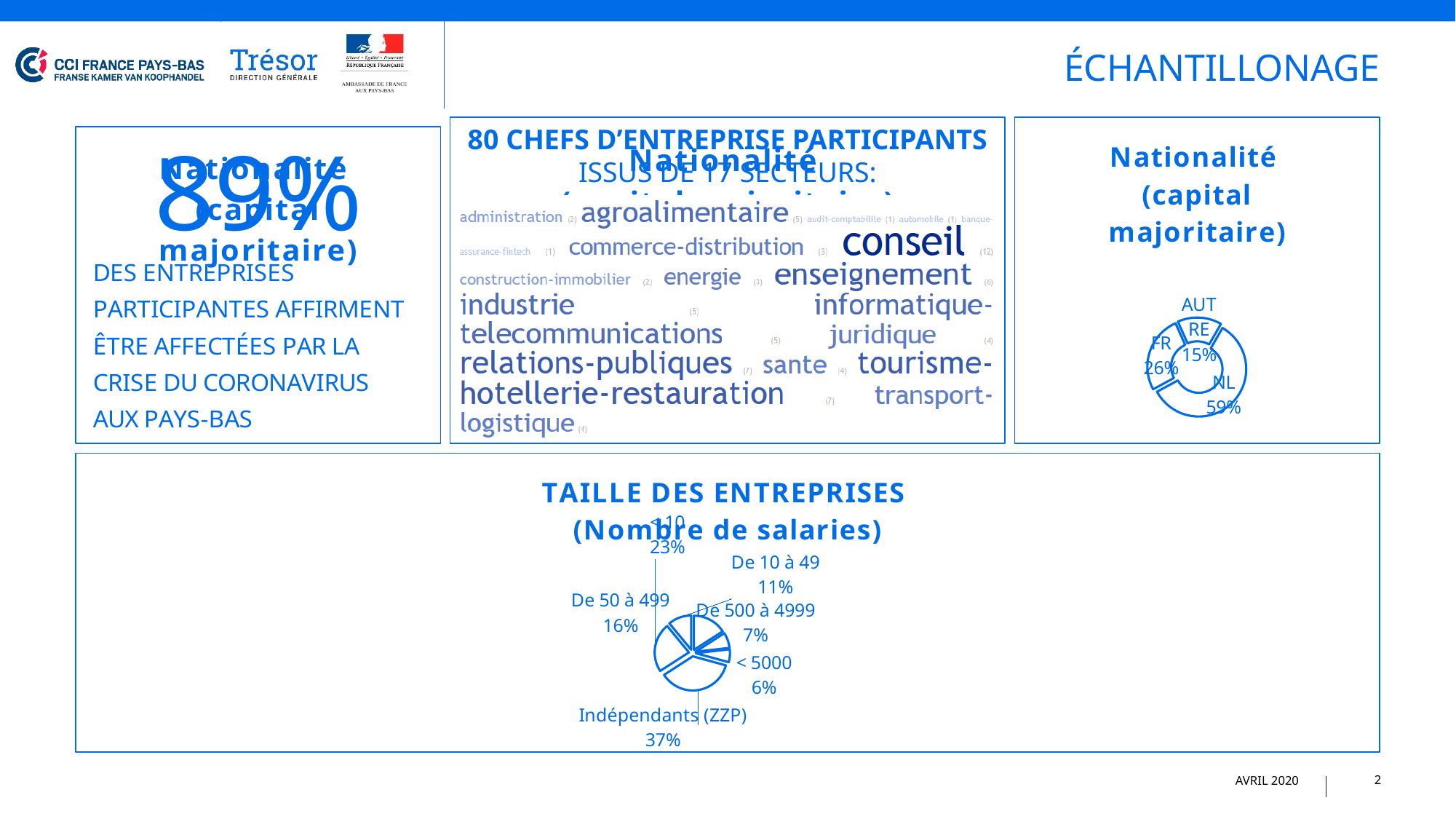
In the 'TAILLE DES ENTREPRISES' chart, which is larger: De 500 à 4999 or De 10 à 49? De 10 à 49 In the 'Nationalité (capital majoritaire)' chart, what is the difference between the NL and FR shares? 33% In the 'Nationalité (capital majoritaire)' chart, what share is shown for NL? 59% In the 'TAILLE DES ENTREPRISES' chart, which category has the smallest share? < 5000 In the 'Nationalité (capital majoritaire)' chart, which category has the largest share? NL In the 'TAILLE DES ENTREPRISES' chart, what share is shown for Indépendants (ZZP)? 37% In the 'TAILLE DES ENTREPRISES' chart, what share is shown for De 50 à 499? 16% What kind of chart is the 'TAILLE DES ENTREPRISES' chart? Pie chart In the 'TAILLE DES ENTREPRISES' chart, what share is shown for De 10 à 49? 11% What kind of chart is the 'Nationalité (capital majoritaire)' chart? Doughnut chart In the 'Nationalité (capital majoritaire)' chart, what share is shown for FR? 26%